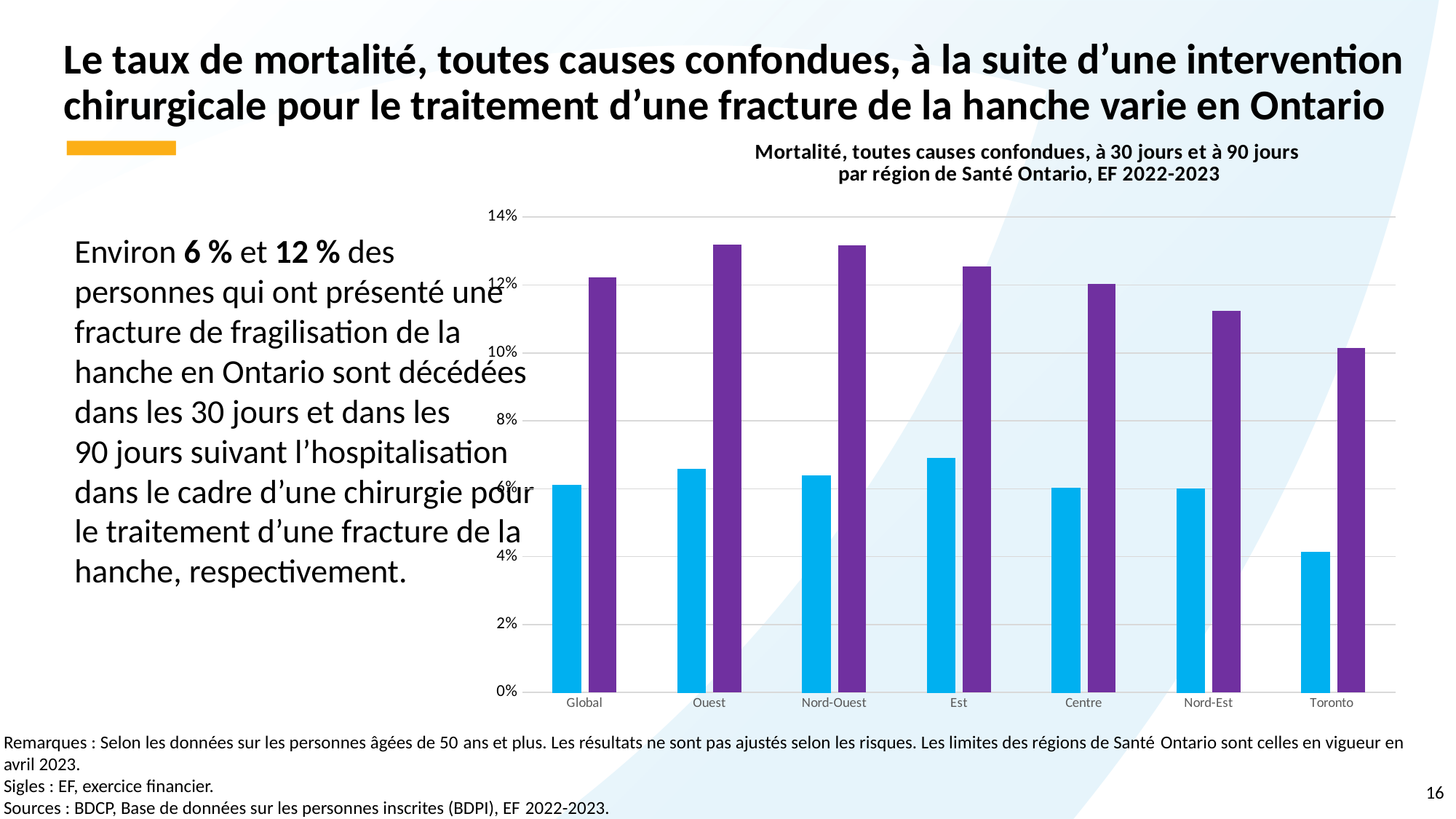
What is the title of the chart? Mortalité, toutes causes confondues, à 30 jours et à 90 jours par région de Santé Ontario, EF 2022-2023 Is the purple (90-day) value for Nord-Est greater or less than 10%? greater How many regions (categories) are shown on the x axis of the chart? 7 Is the purple (90-day) value for Toronto greater or less than 12%? less Which is larger, the blue (30-day) bar for Est or for Toronto? Est Which region has the highest blue (30-day) bar? Est Is the purple (90-day) value for Ouest greater or less than 12%? greater Which region has the lowest blue (30-day) bar? Toronto What kind of chart is shown on the slide? bar chart Which is larger, the purple (90-day) bar for Nord-Est or for Toronto? Nord-Est Which region has the lowest purple (90-day) bar? Toronto